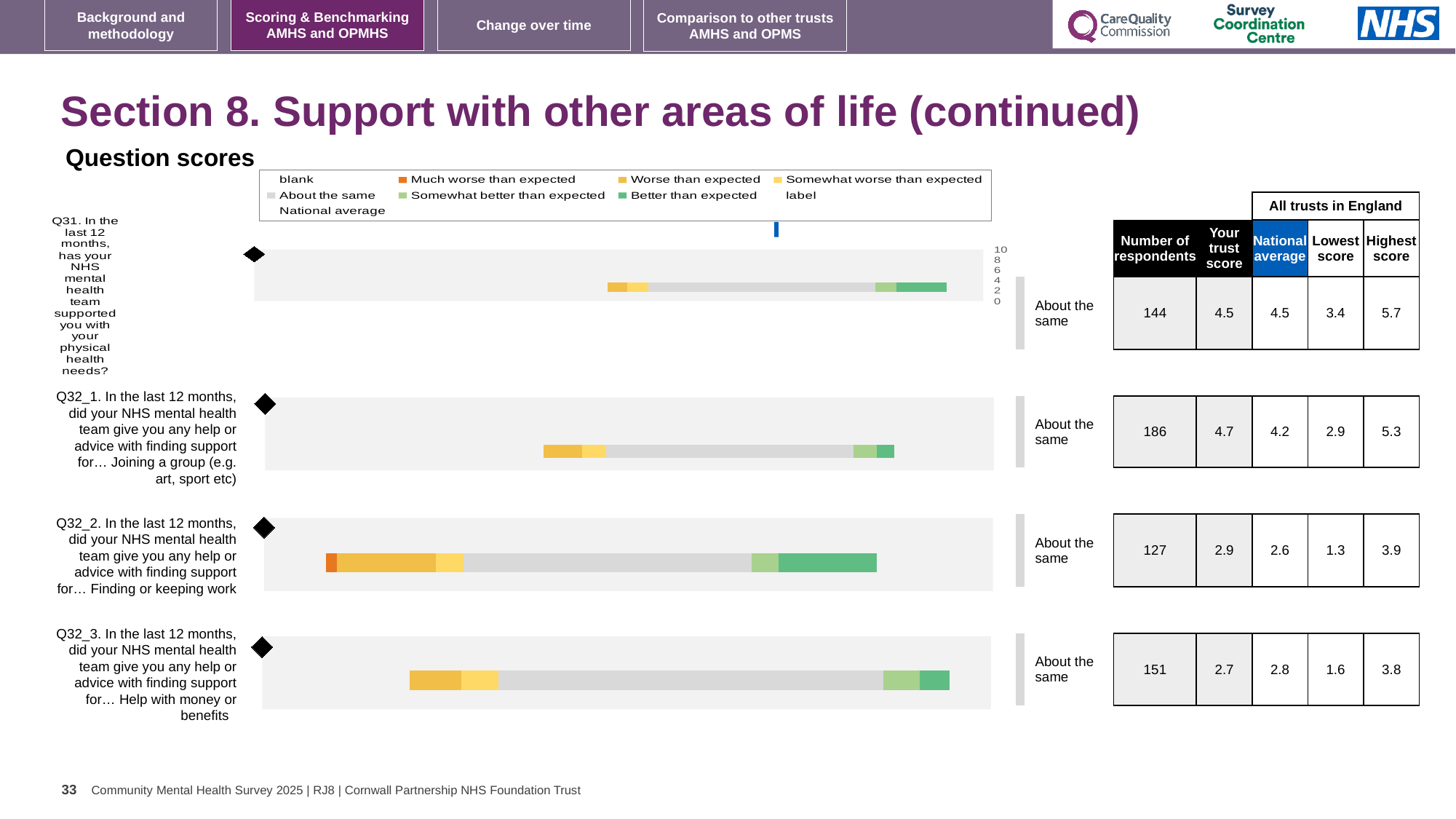
Which question has the lowest 'Your trust score' in the table? Q32_3 In the table, what is 'Your trust score' for Q32_1 (Joining a group)? 4.7 In the table, what is the national average for Q32_3 (Help with money or benefits)? 2.8 How many entries does the legend above the question score charts list? 9 In the table, what is the highest score among all trusts in England for Q31 (physical health needs)? 5.7 What colour represents 'Much worse than expected' in the legend? orange For Q32_2, what is the difference between the highest score and the lowest score among all trusts in England? 2.6 For Q32_1, which is larger: the trust score or the national average? the trust score What kind of chart is used to show the question scores on this slide? bar chart How many questions have a score bar plotted on this slide? 4 Which question has the highest number of respondents in the table? Q32_1 In the table, how many respondents are listed for Q32_2 (Finding or keeping work)? 127